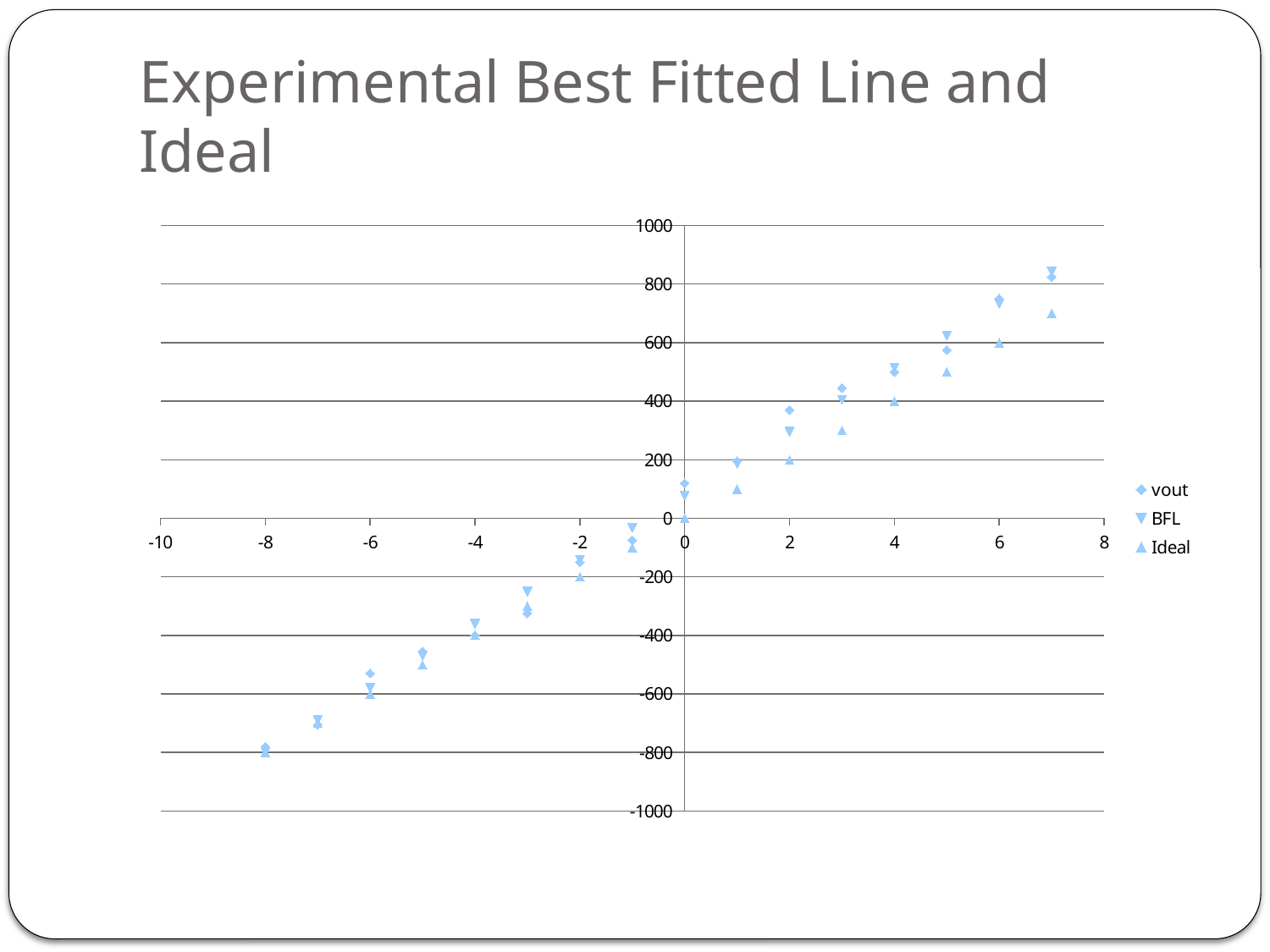
At x = 7, which series has the larger value, BFL or Ideal? BFL What are the names of the series in the legend? vout, BFL, Ideal How many series does the legend list? 3 What is the Ideal value at x = 0? 0 Do the plotted values rise or fall as x increases? rise What is the Ideal value at x = -6? -600 At x = 2, which series has the larger value, vout or Ideal? vout Is the vout value at x = 2 greater or less than 200? greater Is the BFL value at x = 7 greater or less than 800? greater What kind of chart is shown on the slide? scatter chart Is the vout value at x = 6 greater or less than 800? less What is the Ideal value at x = 4? 400